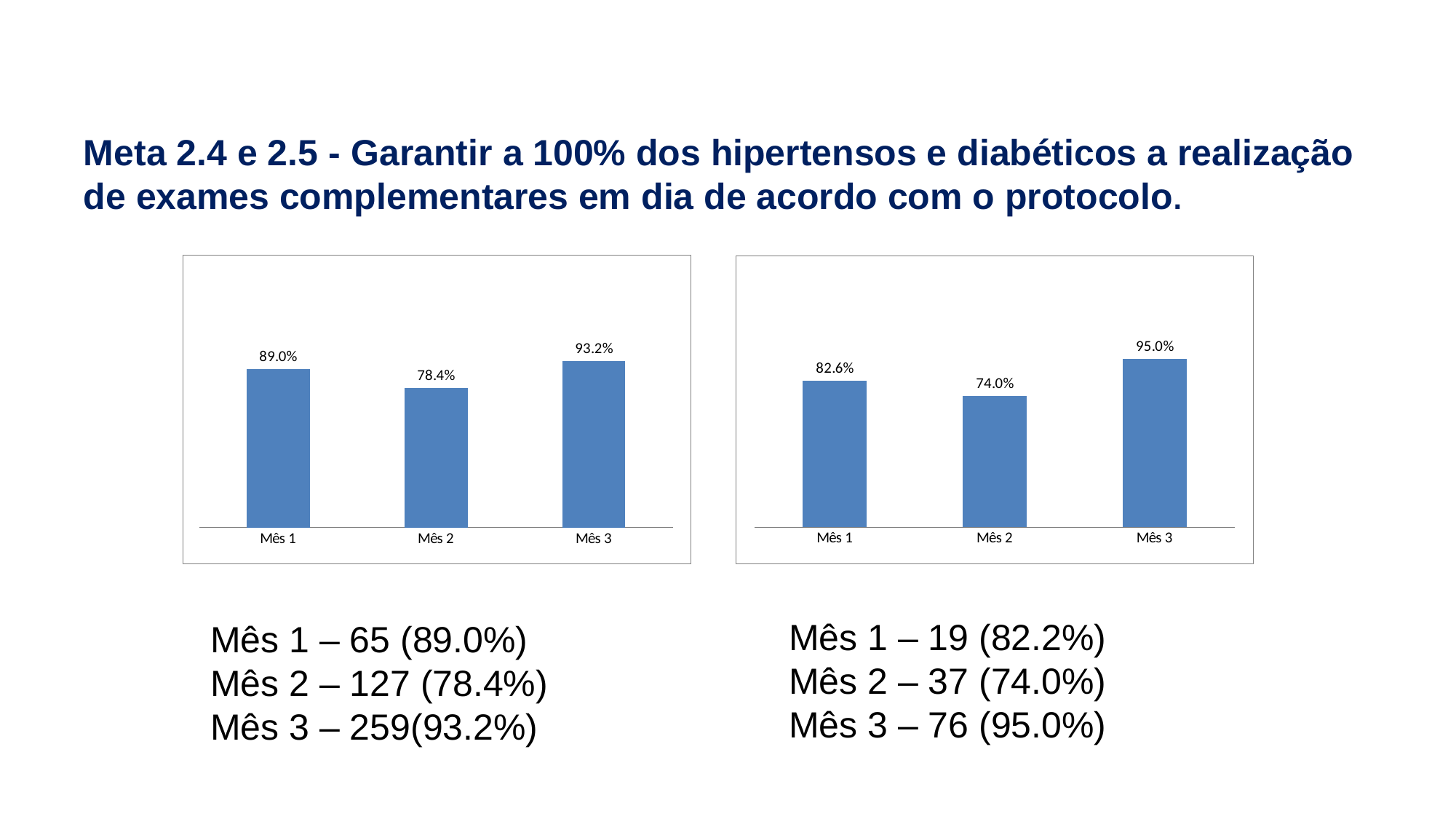
In the right chart, what is the difference between the values for Mês 1 and Mês 2? 8.6% In the right chart, what is the value for Mês 2? 74.0% In the right chart, what is the value for Mês 3? 95.0% In the right chart, which is larger, the value for Mês 1 or the value for Mês 3? Mês 3 What kind of chart is the right chart? Bar chart In the left chart, which month has the highest value? Mês 3 In the left chart, what is the value for Mês 2? 78.4% In the left chart, what is the value for Mês 1? 89.0% In the left chart, does the value rise or fall from Mês 2 to Mês 3? Rise In the right chart, which month has the lowest value? Mês 2 In the left chart, what is the difference between the values for Mês 3 and Mês 2? 14.8% How many bars does the left chart have? 3